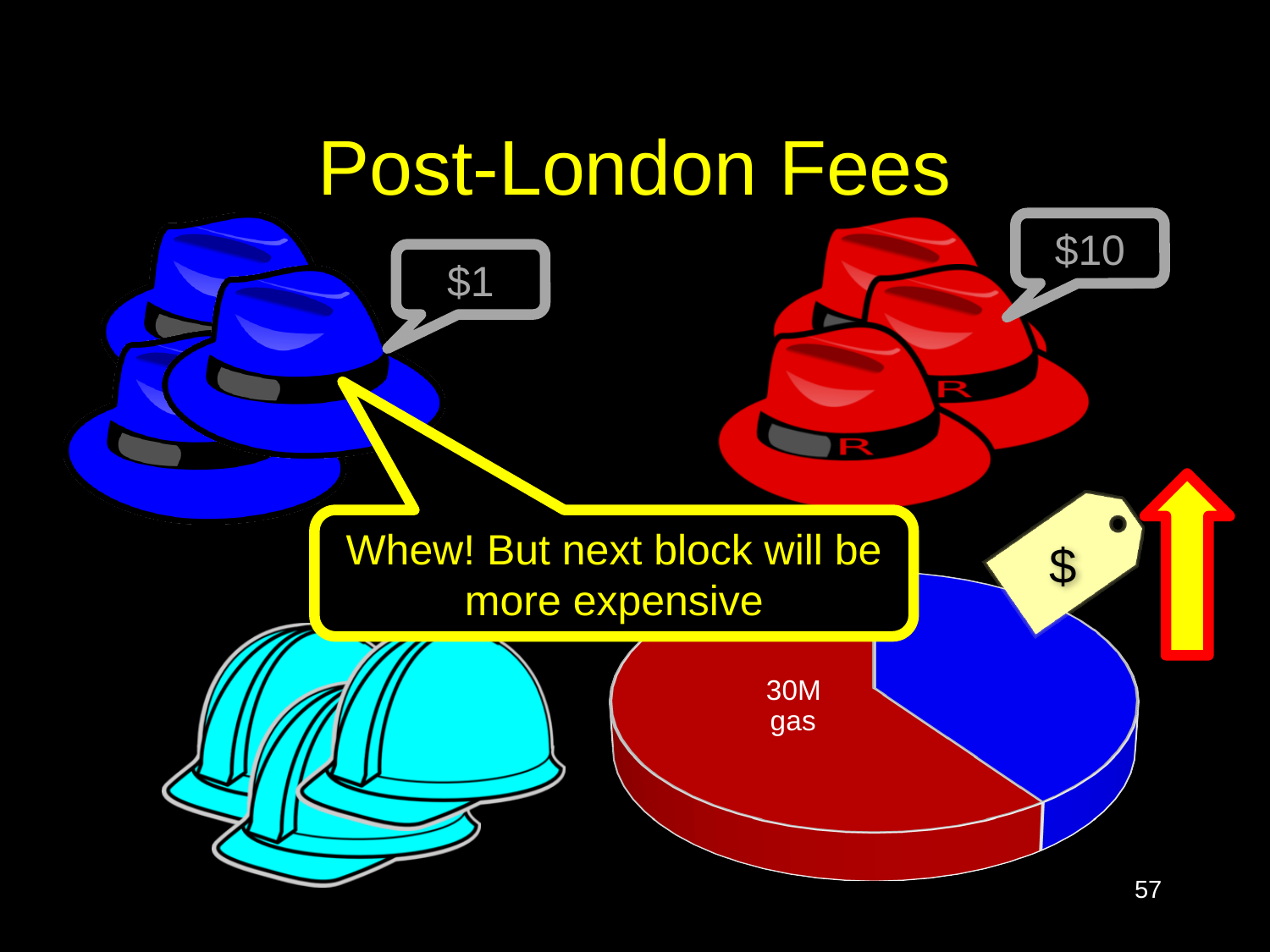
How many slices does the pie chart have? 2 What two colours are used for the slices of the pie chart? red and blue Is the red slice of the pie chart greater or less than half of the pie? greater Which colour slice takes up the largest share of the pie chart? red What label is printed on the red slice of the pie chart? 30M gas Which colour slice takes up the smallest share of the pie chart? blue Which slice of the pie chart is larger, the red one or the blue one? the red one What kind of chart is shown at the bottom right of the slide? pie chart Is the blue slice of the pie chart greater or less than half of the pie? less What is the title of the slide containing the pie chart? Post-London Fees